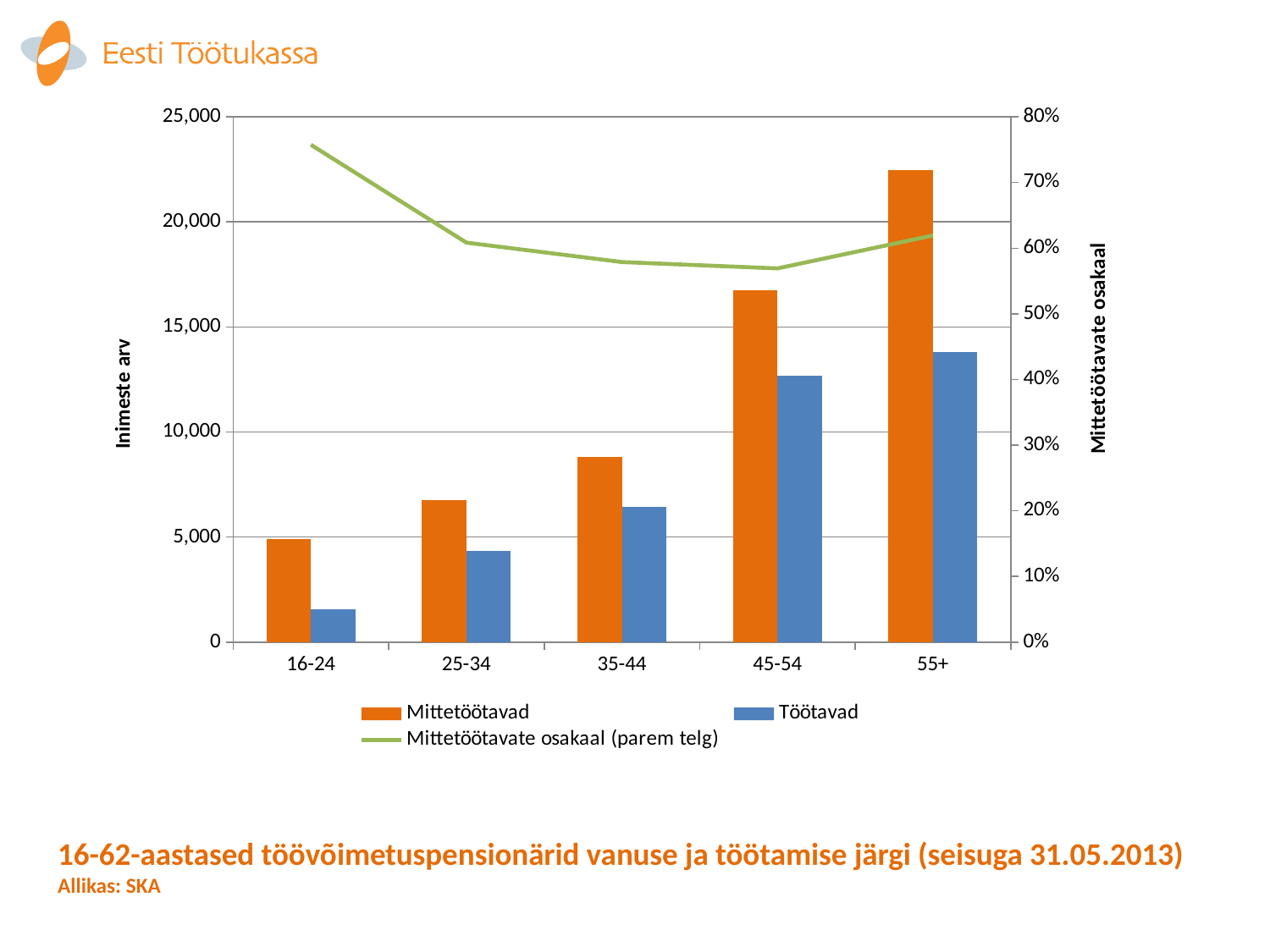
What kind of chart is shown on the slide? A bar chart combined with a line chart Is the Töötavad value for 16-24 greater or less than 5,000? less Do the Mittetöötavad bars rise or fall as the age groups go from 16-24 to 55+? rise How many age groups are shown on the x axis? 5 How many series does the legend list? 3 At which age group is the Mittetöötavate osakaal line highest? 16-24 Is the Mittetöötavad value for 55+ greater or less than 20,000? greater Which age group has the highest Mittetöötavad bar? 55+ For the 45-54 age group, which is larger: Mittetöötavad or Töötavad? Mittetöötavad Is the Mittetöötavate osakaal value for 16-24 greater or less than 70%? greater Which age group has the lowest Töötavad bar? 16-24